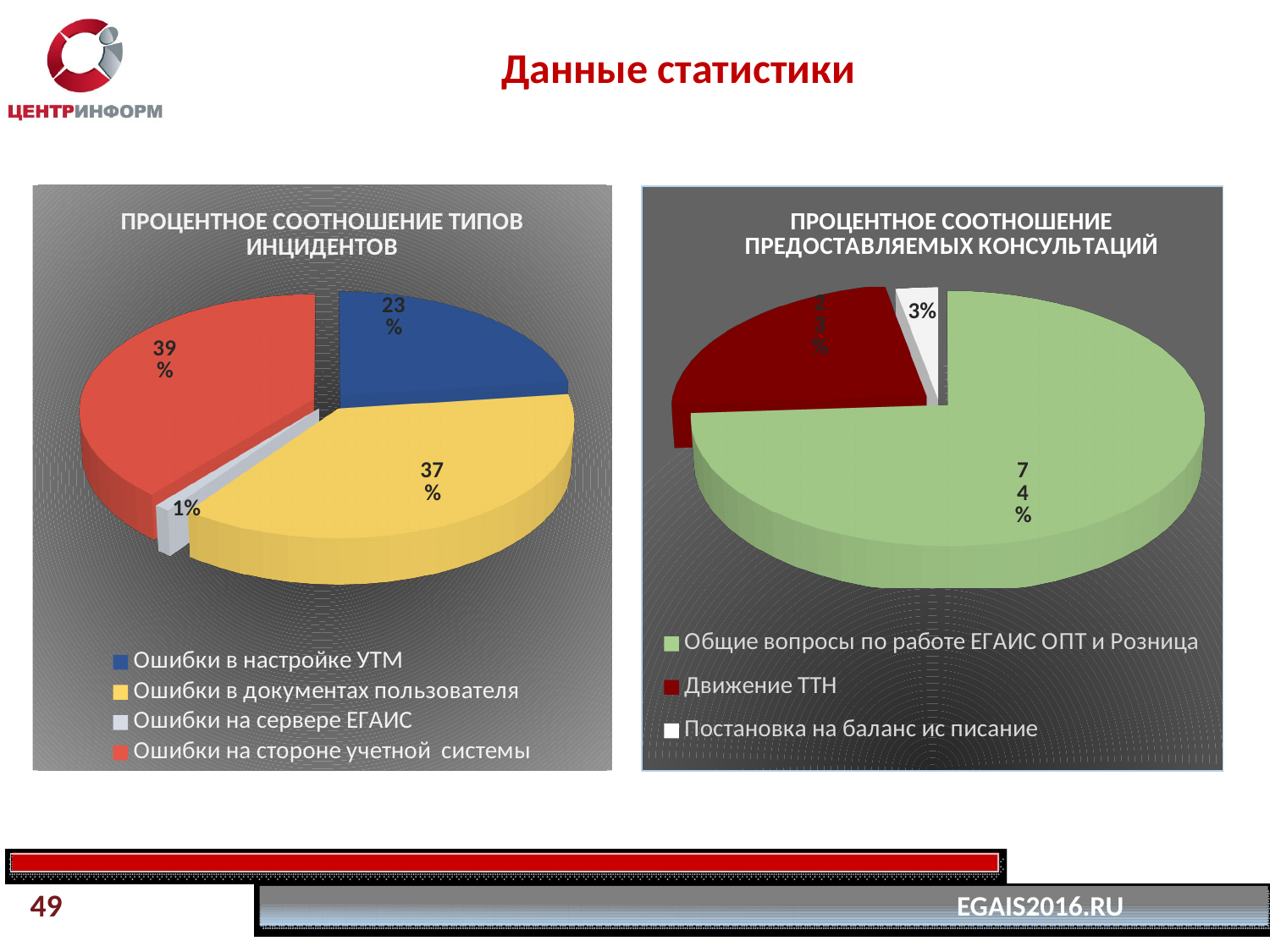
In the left chart (ПРОЦЕНТНОЕ СООТНОШЕНИЕ ТИПОВ ИНЦИДЕНТОВ), what percentage is shown for Ошибки в настройке УТМ? 23% In the right chart (ПРОЦЕНТНОЕ СООТНОШЕНИЕ ПРЕДОСТАВЛЯЕМЫХ КОНСУЛЬТАЦИЙ), what percentage is shown for Общие вопросы по работе ЕГАИС ОПТ и Розница? 74% What type of chart is the left chart (ПРОЦЕНТНОЕ СООТНОШЕНИЕ ТИПОВ ИНЦИДЕНТОВ)? Pie chart In the left chart (ПРОЦЕНТНОЕ СООТНОШЕНИЕ ТИПОВ ИНЦИДЕНТОВ), what percentage is shown for Ошибки в документах пользователя? 37% In the right chart (ПРОЦЕНТНОЕ СООТНОШЕНИЕ ПРЕДОСТАВЛЯЕМЫХ КОНСУЛЬТАЦИЙ), how many categories does the legend list? 3 In the left chart (ПРОЦЕНТНОЕ СООТНОШЕНИЕ ТИПОВ ИНЦИДЕНТОВ), which category has the largest share? Ошибки на стороне учетной системы In the right chart (ПРОЦЕНТНОЕ СООТНОШЕНИЕ ПРЕДОСТАВЛЯЕМЫХ КОНСУЛЬТАЦИЙ), which category has the smallest share? Постановка на баланс ис писание In the right chart (ПРОЦЕНТНОЕ СООТНОШЕНИЕ ПРЕДОСТАВЛЯЕМЫХ КОНСУЛЬТАЦИЙ), which is larger: Движение ТТН or Постановка на баланс и списание? Движение ТТН In the left chart (ПРОЦЕНТНОЕ СООТНОШЕНИЕ ТИПОВ ИНЦИДЕНТОВ), how many categories does the legend list? 4 In the left chart (ПРОЦЕНТНОЕ СООТНОШЕНИЕ ТИПОВ ИНЦИДЕНТОВ), what is the difference between the shares for Ошибки на стороне учетной системы and Ошибки в настройке УТМ? 16% In the left chart (ПРОЦЕНТНОЕ СООТНОШЕНИЕ ТИПОВ ИНЦИДЕНТОВ), which category has the smallest share? Ошибки на сервере ЕГАИС In the right chart (ПРОЦЕНТНОЕ СООТНОШЕНИЕ ПРЕДОСТАВЛЯЕМЫХ КОНСУЛЬТАЦИЙ), what percentage is shown for Движение ТТН? 23%